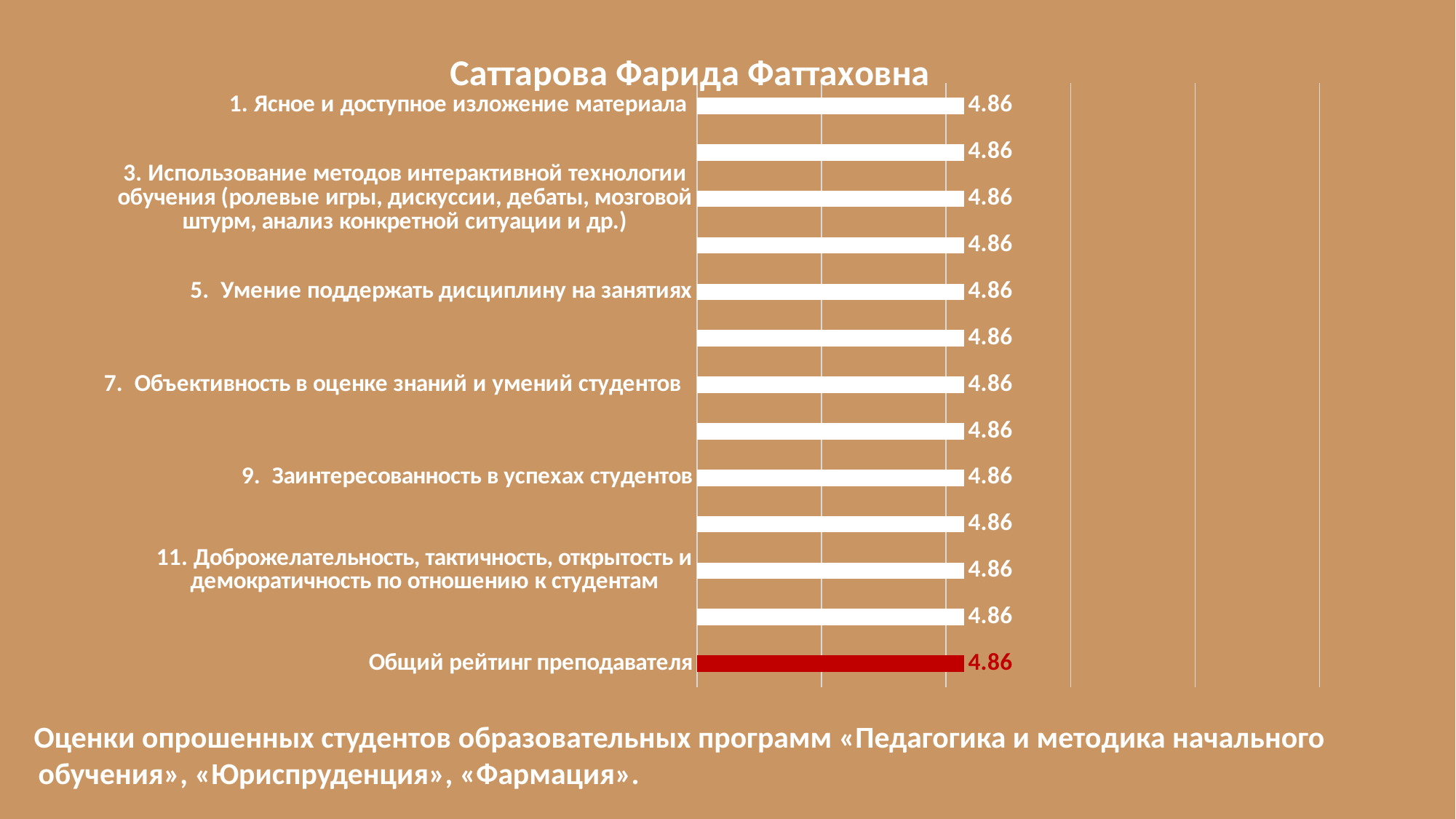
What is the value for "5. Умение поддержать дисциплину на занятиях"? 4.86 What is the title of the chart? Саттарова Фарида Фаттаховна What is the value for "9. Заинтересованность в успехах студентов"? 4.86 What is the value for "Общий рейтинг преподавателя"? 4.86 Do the values change from the top bar to the bottom bar of the chart? No, all values are 4.86 What is the value for "11. Доброжелательность, тактичность, открытость и демократичность по отношению к студентам"? 4.86 Which bar is shown in a different colour (red) from the others? Общий рейтинг преподавателя How many bars are plotted in the chart? 13 What is the difference between the value for "1. Ясное и доступное изложение материала" and the value for "Общий рейтинг преподавателя"? 0 What type of chart is shown on the slide? bar chart What is the value for "1. Ясное и доступное изложение материала"? 4.86 What is the value for "7. Объективность в оценке знаний и умений студентов"? 4.86